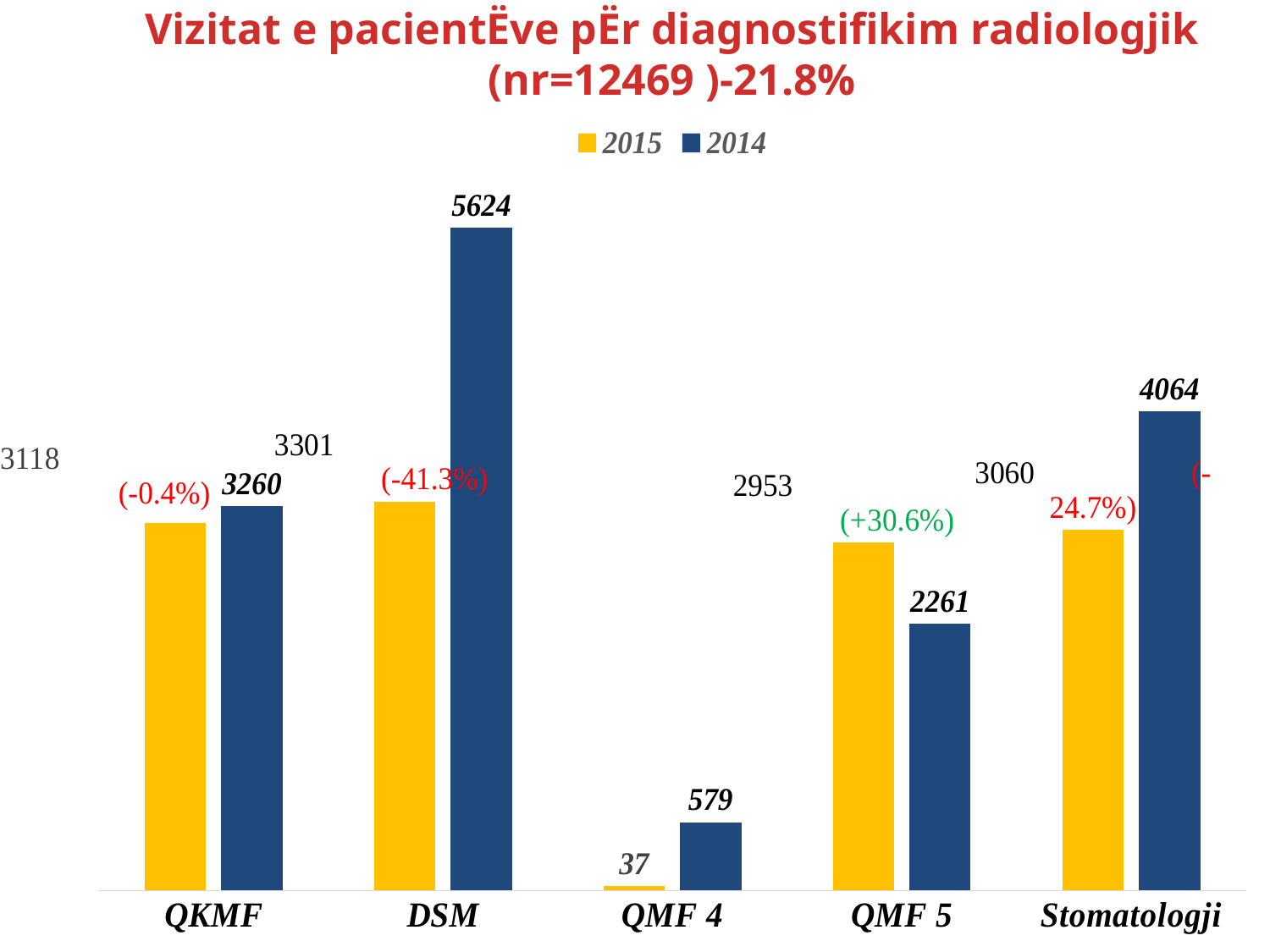
For QMF 5, which series has the larger value, 2015 or 2014? 2015 What is the 2014 value for QMF 5? 2261 What is the 2015 value for QMF 4? 37 How many categories are shown on the x axis? 5 Which category has the lowest 2014 value? QMF 4 What is the difference between the 2014 values for DSM and QKMF? 2364 How many series does the legend list? 2 Which category has the highest 2014 value? DSM What is the 2014 value for DSM? 5624 What is the 2014 value for Stomatologji? 4064 What percentage change is printed above the DSM bars? (-41.3%) What kind of chart is shown on the slide? bar chart